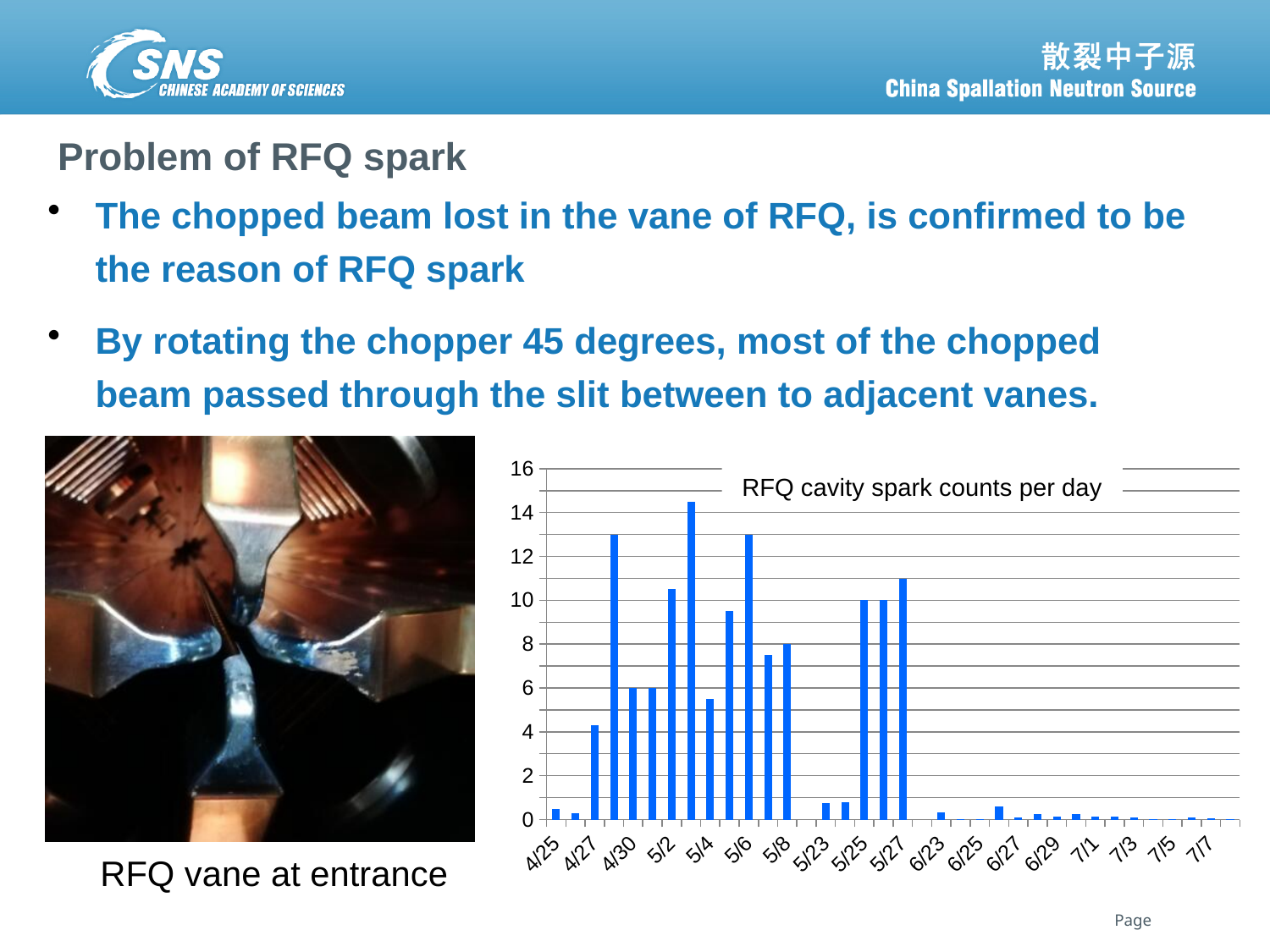
What kind of chart is shown on the right side of the slide? bar chart Do the spark counts generally rise or fall from late May through July? fall Is the value for 6/23 greater or less than 2? less Which has the higher spark count, 5/27 or 6/25? 5/27 Is the value for 5/2 greater or less than 8? greater Is the value for 7/7 greater or less than 2? less Which has the higher spark count, 5/6 or 5/4? 5/6 What is the highest value shown on the vertical axis of the chart? 16 What is the title of the chart on the slide? RFQ cavity spark counts per day